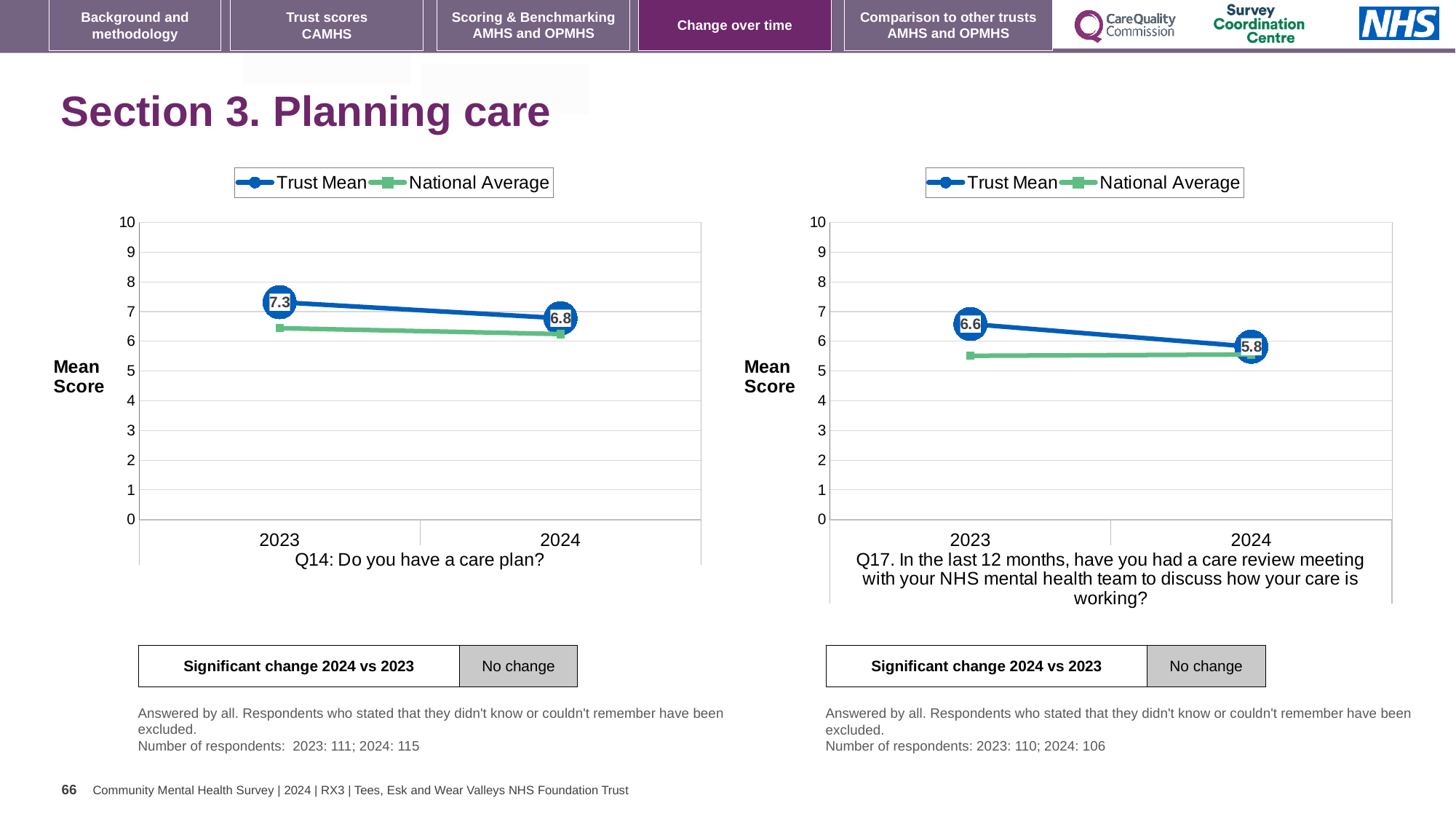
How many series does the legend of the right chart (Q17) list? 2 In the left chart (Q14), which is higher in 2023: the Trust Mean or the National Average? Trust Mean In the right chart (Q17, care review meeting), what is the Trust Mean score for 2024? 5.8 In the right chart (Q17), what is the difference between the Trust Mean in 2023 and in 2024? 0.8 What type of chart is the left chart (Q14)? line chart In the right chart (Q17, care review meeting), what is the Trust Mean score for 2023? 6.6 In the left chart (Q14: Do you have a care plan?), what is the Trust Mean score for 2024? 6.8 In the left chart (Q14), by how much did the Trust Mean change from 2023 to 2024? 0.5 In the right chart (Q17), does the Trust Mean rise or fall from 2023 to 2024? fall In the left chart (Q14: Do you have a care plan?), what is the Trust Mean score for 2023? 7.3 How many years are plotted on the x axis of the left chart (Q14)? 2 In the right chart (Q17), is the National Average value for 2023 greater or less than 6? less